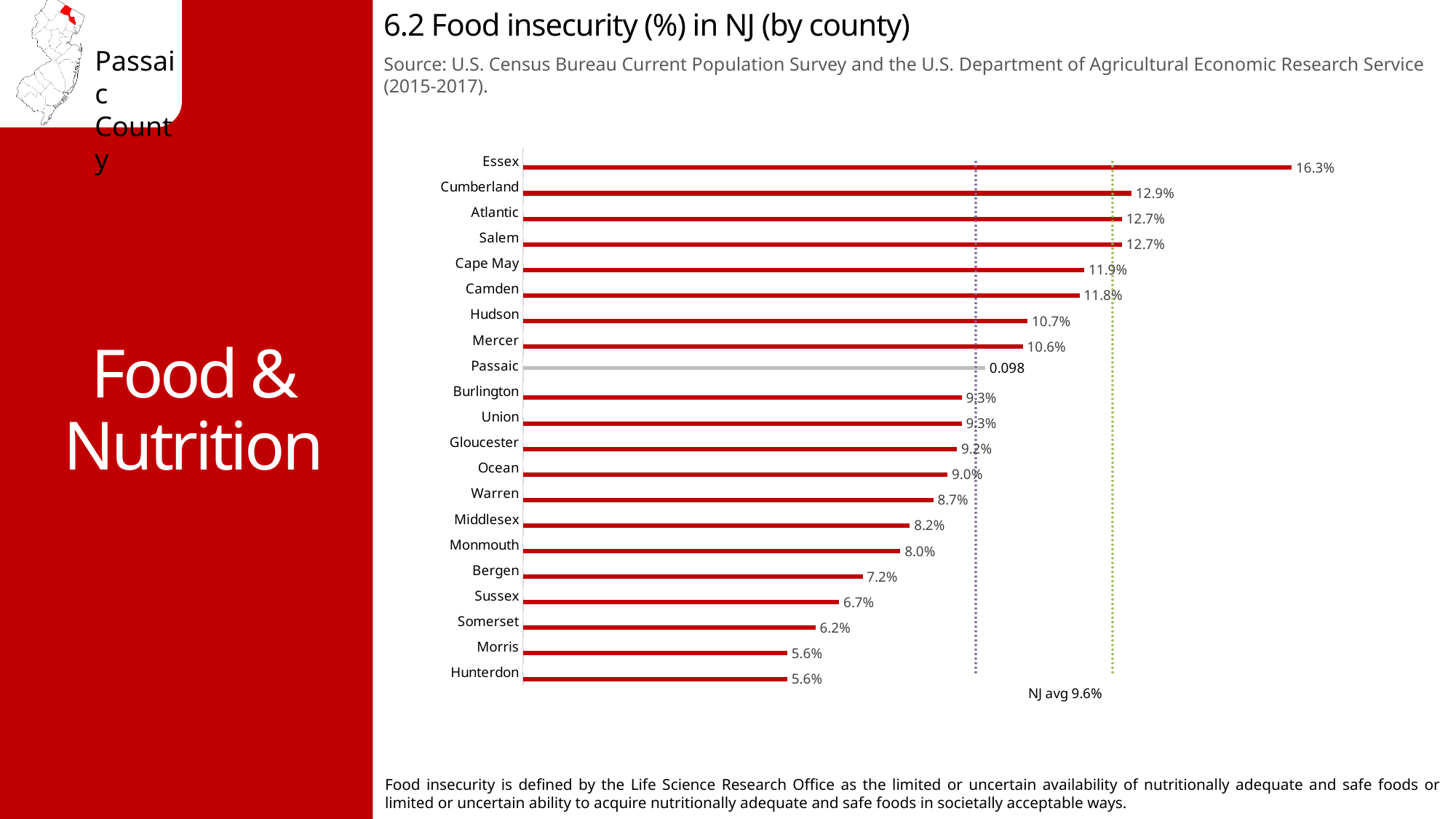
Which county has a higher food insecurity percentage, Somerset or Monmouth? Monmouth What is the difference between the food insecurity values for Essex and Cumberland? 3.4% What is the food insecurity percentage for Bergen county? 7.2% Which county's bar is drawn in grey rather than red? Passaic What kind of chart is used to show food insecurity by county? Bar chart What value is labelled for Passaic county on the chart? 0.098 Which county has the highest food insecurity percentage? Essex What is the difference between the values for Camden and Hudson? 1.1% What is the food insecurity value shown for Essex county? 16.3% What NJ average value is noted on the chart? 9.6% Which county has a higher food insecurity percentage, Mercer or Ocean? Mercer How many counties are plotted on the chart? 21